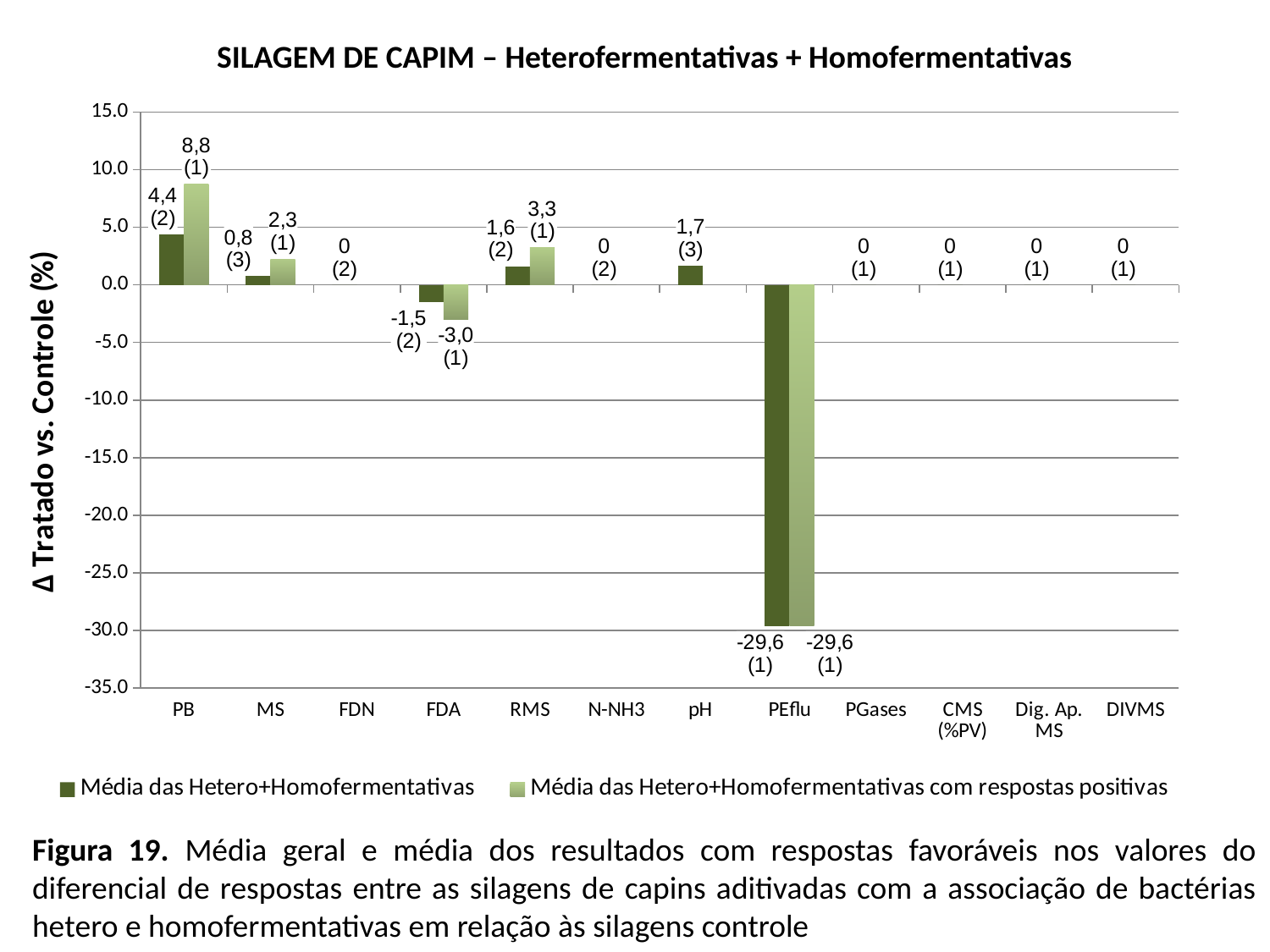
In the 'Média das Hetero+Homofermentativas com respostas positivas' series, which is larger: RMS or MS? RMS What is the value for FDA in the 'Média das Hetero+Homofermentativas com respostas positivas' series? -3,0 What is the value for PB in the 'Média das Hetero+Homofermentativas' series? 4,4 How many categories are shown on the x axis? 12 What is the title of the chart? SILAGEM DE CAPIM – Heterofermentativas + Homofermentativas What is the value for PB in the 'Média das Hetero+Homofermentativas com respostas positivas' series? 8,8 What is the value for PEflu in the 'Média das Hetero+Homofermentativas' series? -29,6 Which category has the lowest value in the 'Média das Hetero+Homofermentativas' series? PEflu Which category has the highest value in the 'Média das Hetero+Homofermentativas com respostas positivas' series? PB For PB, what is the difference between the 'com respostas positivas' series value and the 'Média das Hetero+Homofermentativas' value? 4,4 What kind of chart is shown on the slide? Bar chart How many series does the legend list? 2